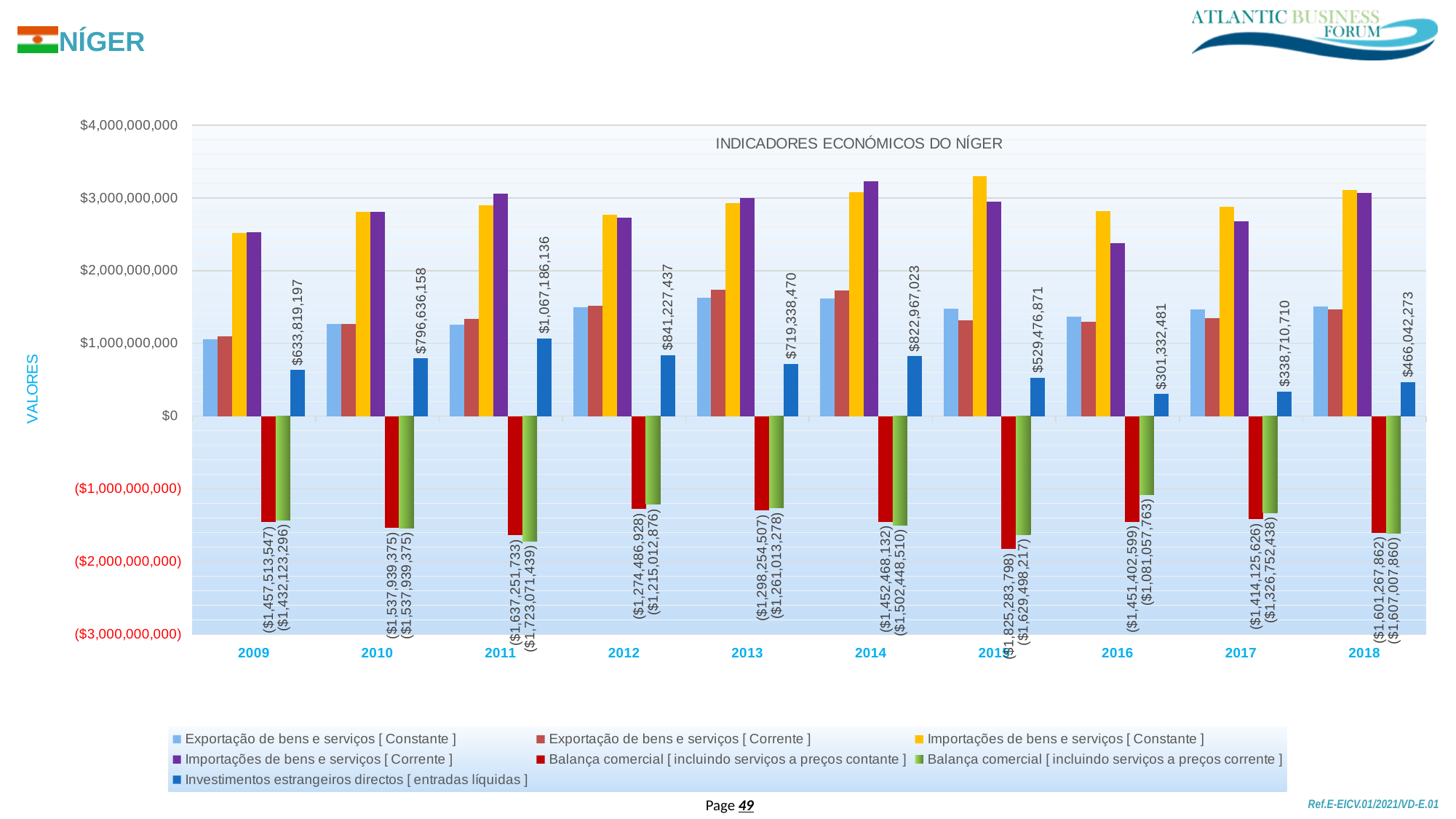
By how much does Investimentos estrangeiros directos [ entradas líquidas ] in 2011 exceed the value in 2012? $225,958,699 What is the value of Investimentos estrangeiros directos [ entradas líquidas ] for 2011? $1,067,186,136 In which year is Investimentos estrangeiros directos [ entradas líquidas ] lowest? 2016 Is the value of Importações de bens e serviços [ Constante ] for 2015 greater or less than $3,000,000,000? greater How many series does the legend list? 7 What kind of chart is shown on the slide? bar chart What is the value of Balança comercial [ incluindo serviços a preços contante ] for 2015? ($1,825,283,798) In which year is Investimentos estrangeiros directos [ entradas líquidas ] highest? 2011 What is the value of Investimentos estrangeiros directos [ entradas líquidas ] for 2016? $301,332,481 How many years are shown on the x axis of the chart? 10 What is the title of the chart? INDICADORES ECONÓMICOS DO NÍGER What is the value of Balança comercial [ incluindo serviços a preços corrente ] for 2016? ($1,081,057,763)